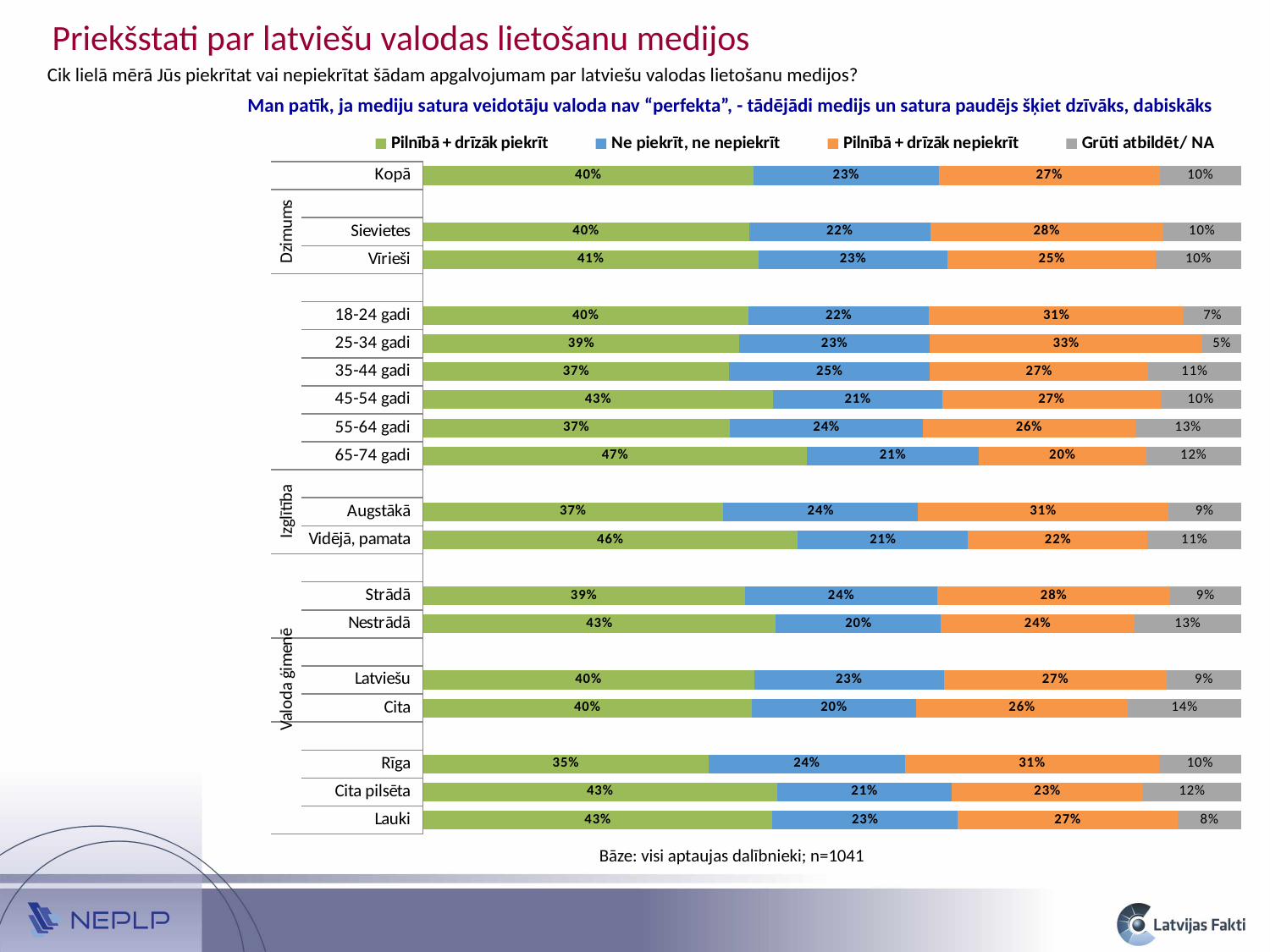
What kind of chart is shown on the slide? Stacked bar chart Which category has the highest "Pilnībā + drīzāk piekrīt" value? 65-74 gadi How many categories (bars) are plotted in the chart? 18 Which colour represents the "Ne piekrīt, ne nepiekrīt" series? Blue Which category has the lowest "Pilnībā + drīzāk piekrīt" value? Rīga What percentage of the Kopā group falls in the "Pilnībā + drīzāk piekrīt" series? 40% What is the "Grūti atbildēt/ NA" value for the 25-34 gadi group? 5% What is the "Pilnībā + drīzāk nepiekrīt" value for Rīga? 31% How many series does the legend list? 4 What is the difference between the "Pilnībā + drīzāk nepiekrīt" values for Augstākā and Vidējā, pamata? 9% Which has a larger "Grūti atbildēt/ NA" value, Cita or Latviešu? Cita What is the total of the stacked bar for 55-64 gadi? 100%